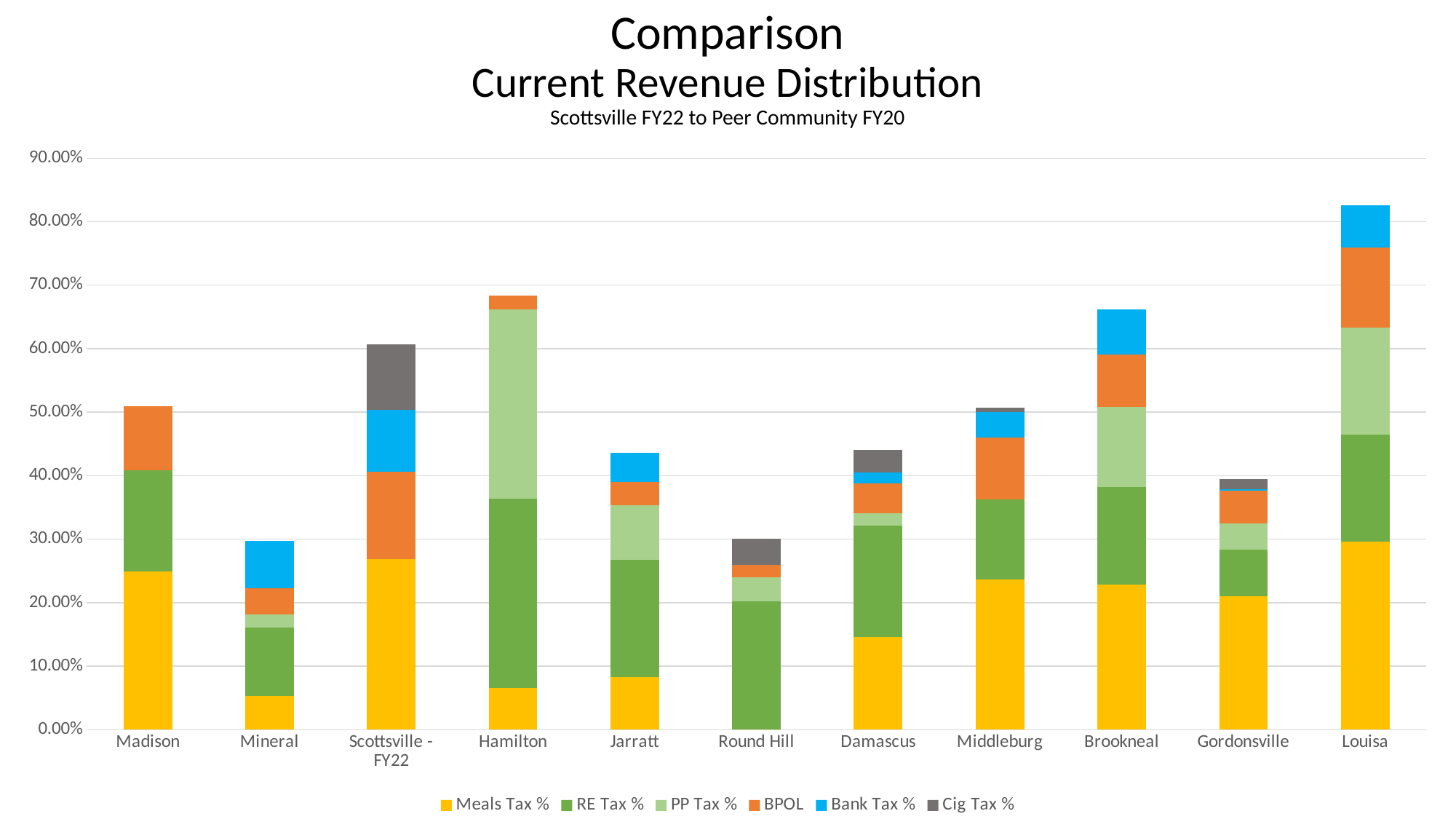
Is the total stacked value for Hamilton greater or less than 60.00%? greater What is the subtitle shown beneath 'Current Revenue Distribution'? Scottsville FY22 to Peer Community FY20 Which community has the largest PP Tax % segment? Hamilton Which community has the highest total stacked bar? Louisa How many communities (categories) are plotted along the x axis? 11 Is the total stacked value for Louisa greater or less than 80.00%? greater Is the total stacked value for Damascus greater or less than 50.00%? less Which has the larger total stacked bar, Madison or Jarratt? Madison Which community has the largest Cig Tax % segment? Scottsville - FY22 What kind of chart is shown on the slide? Stacked bar chart How many series does the legend list? 6